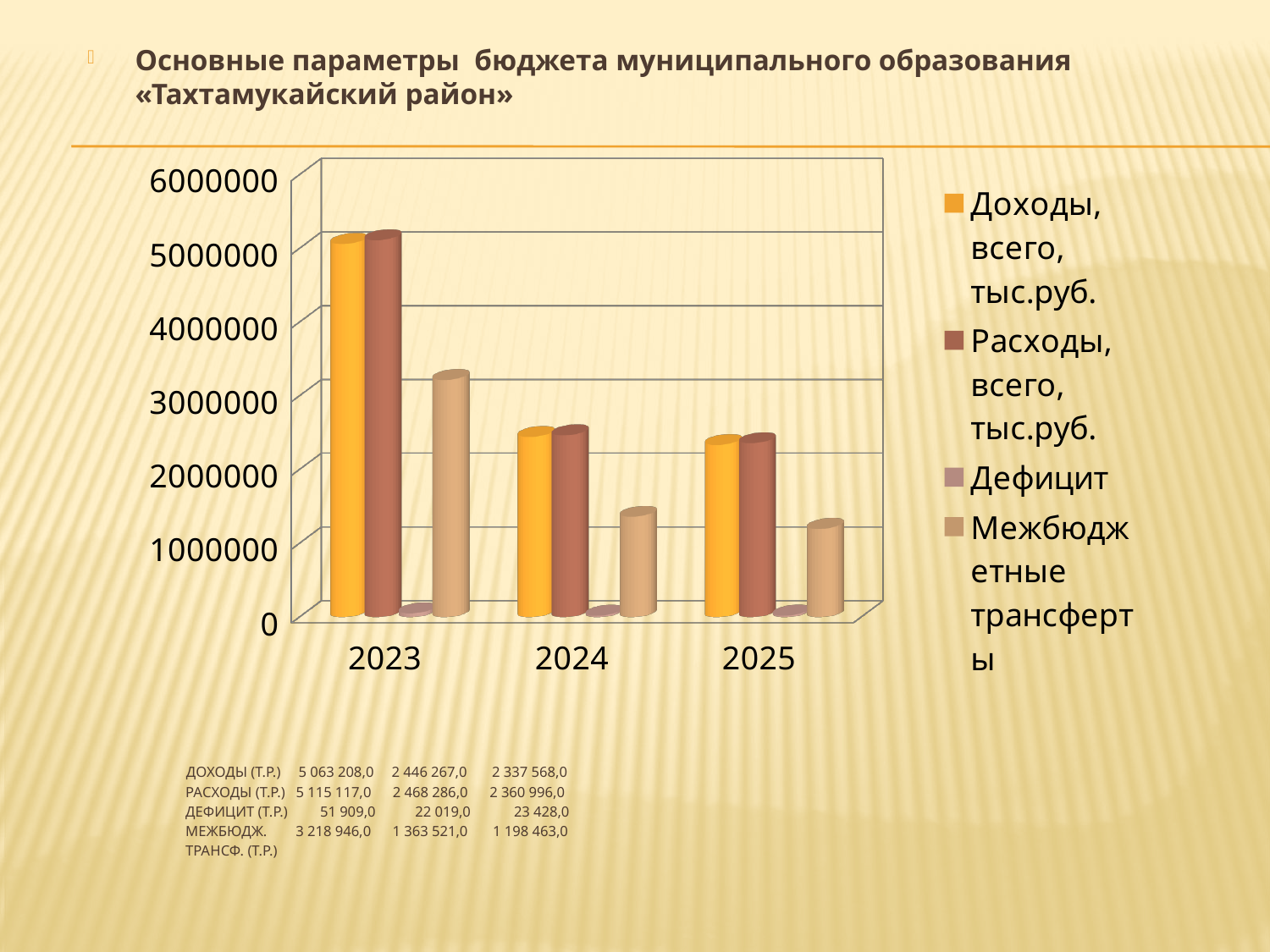
Do the values for Доходы, всего rise or fall from 2023 to 2025? fall According to the figures printed below the chart, what is the value of ДОХОДЫ (Т.Р.) for 2023? 5 063 208,0 What kind of chart is shown on the slide? bar chart In which year is the value for Доходы, всего highest? 2023 According to the figures printed below the chart, what is the value of ДЕФИЦИТ (Т.Р.) for 2025? 23 428,0 Which is larger: Межбюджетные трансферты in 2023 or in 2024? 2023 Is the value for Доходы, всего in 2024 greater or less than 2000000? greater Is the value for Межбюджетные трансферты in 2023 greater or less than 3000000? greater In which year is the value for Межбюджетные трансферты lowest? 2025 Which series is shown in orange in the chart legend? Доходы, всего, тыс.руб. How many years are shown on the x axis of the chart? 3 How many series does the chart legend list? 4